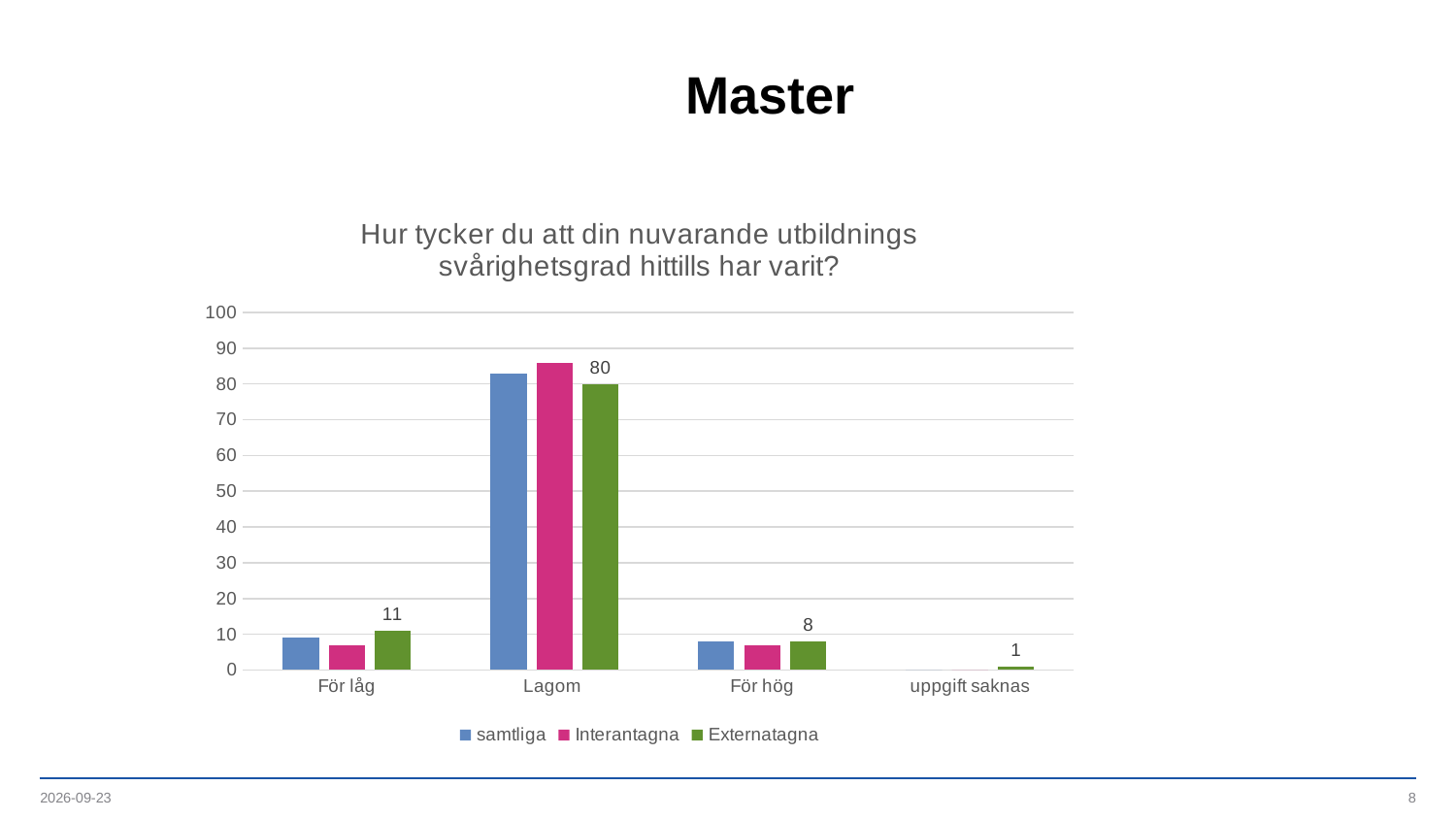
Which category has the highest value for Externatagna? Lagom What is the difference between the Externatagna values for Lagom and För låg? 69 What is the value for Externatagna in the Lagom category? 80 Which category has the lowest value for Externatagna? uppgift saknas What is the value for Externatagna in the uppgift saknas category? 1 Is the value for samtliga in the Lagom category greater or less than 70? greater What is the value for Externatagna in the För låg category? 11 Is the value for Interantagna in the För hög category greater or less than 10? less What is the value for Externatagna in the För hög category? 8 What type of chart is shown on the slide? bar chart How many series does the legend list? 3 How many categories are shown on the x axis? 4